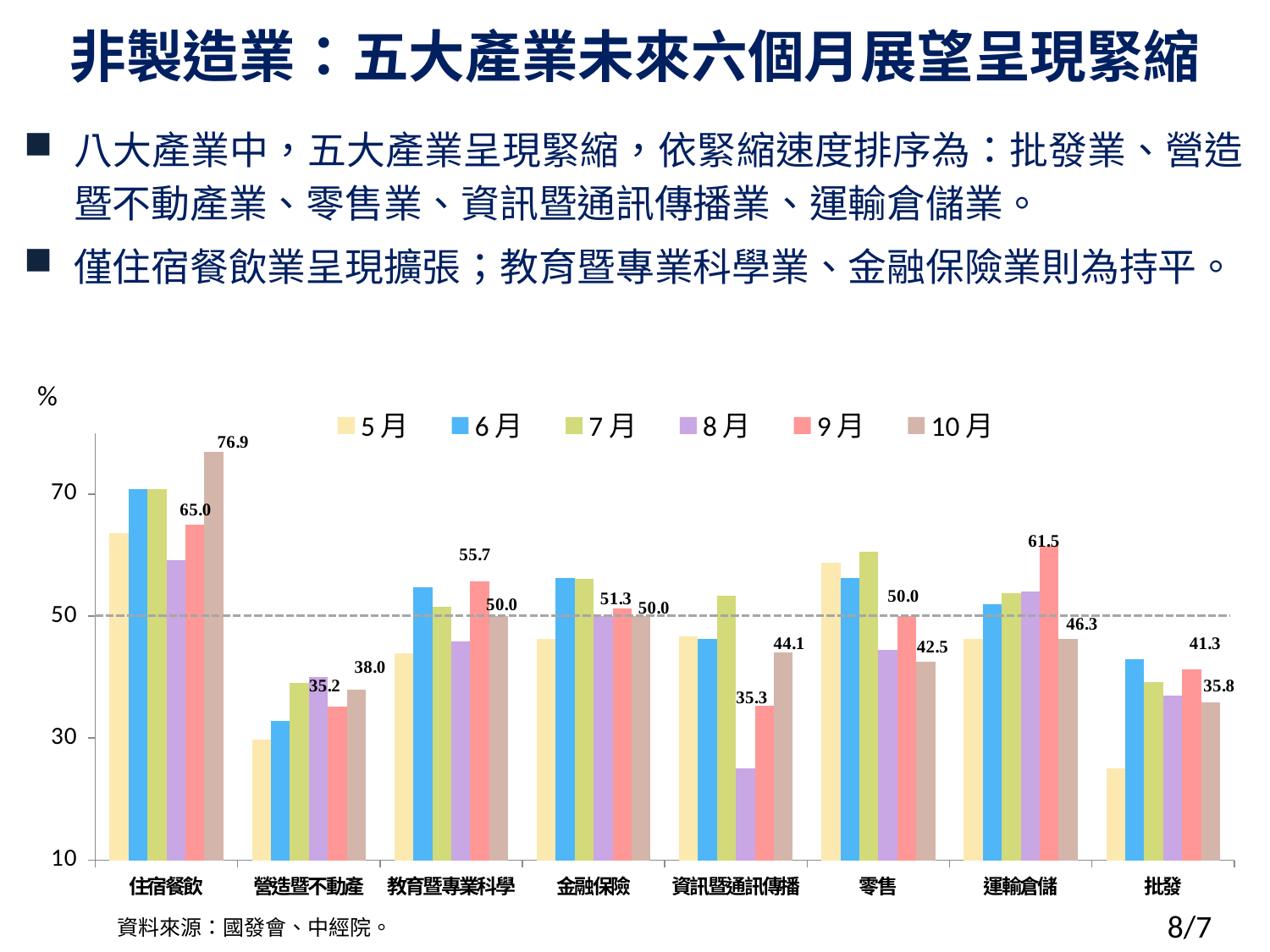
Which industry has the highest 10月 value? 住宿餐飲 How many series does the legend list? 6 Which is larger for 零售: the 9月 value or the 10月 value? 9月 Is the 8月 value for 資訊暨通訊傳播 greater or less than 30? less How many industries are shown on the x axis? 8 Which industry has the lowest 10月 value? 批發 What kind of chart is shown on the slide? bar chart What is the 9月 value for 運輸倉儲? 61.5 What is the 10月 value for 住宿餐飲? 76.9 What is the difference between the 9月 and 10月 values for 運輸倉儲? 15.2 What is the 10月 value for 資訊暨通訊傳播? 44.1